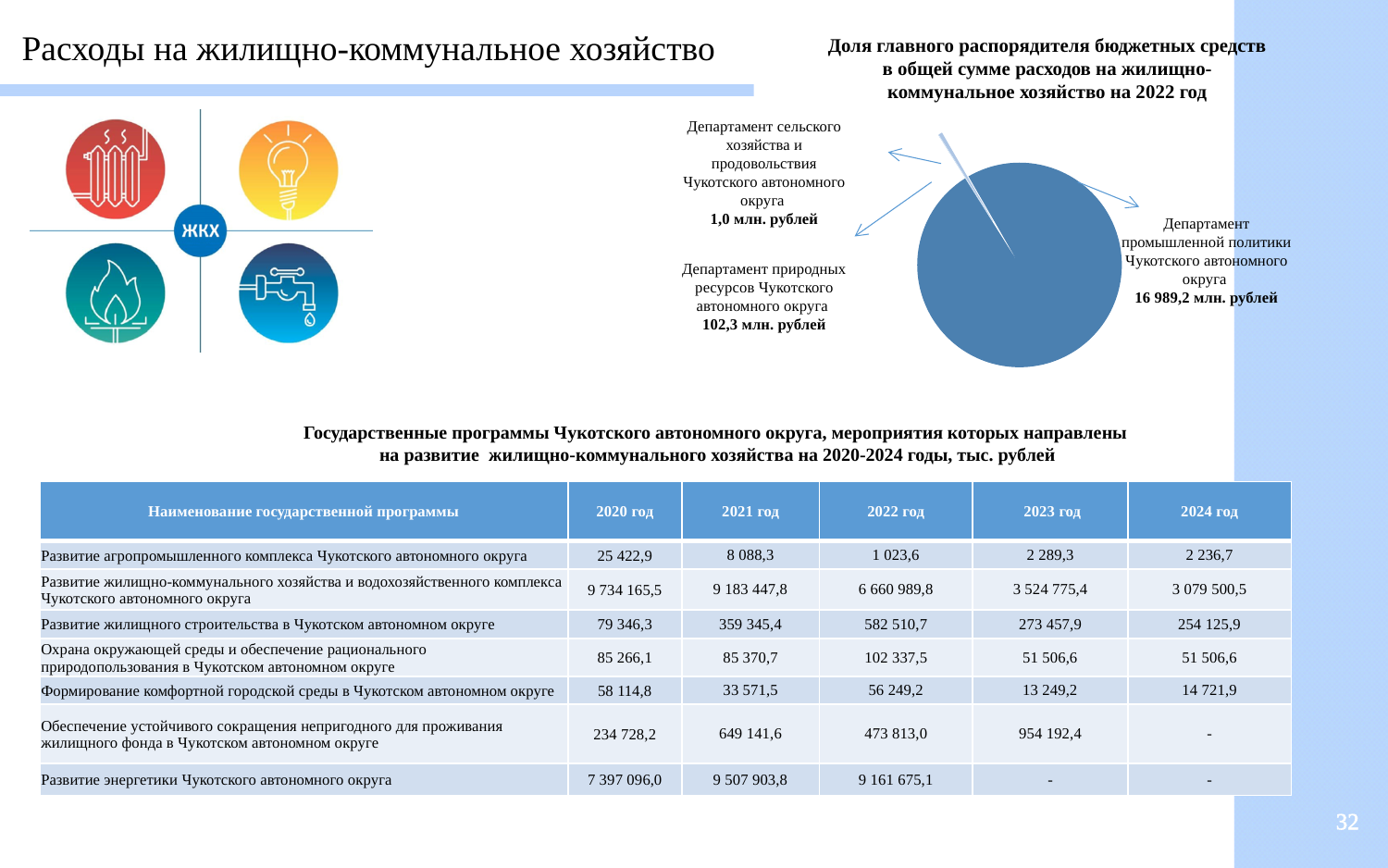
What is the difference between the values for Департамент промышленной политики and Департамент природных ресурсов in the pie chart? 16 886,9 млн. рублей Which department has the largest share in the pie chart? Департамент промышленной политики Чукотского автономного округа Which is larger in the pie chart: the value for Департамент природных ресурсов or the value for Департамент сельского хозяйства и продовольствия? Департамент природных ресурсов What is the value shown for Департамент природных ресурсов Чукотского автономного округа in the pie chart? 102,3 млн. рублей What is the value shown for Департамент сельского хозяйства и продовольствия Чукотского автономного округа in the pie chart? 1,0 млн. рублей What is the difference between the values for Департамент природных ресурсов and Департамент сельского хозяйства и продовольствия in the pie chart? 101,3 млн. рублей What is the title of the pie chart? Доля главного распорядителя бюджетных средств в общей сумме расходов на жилищно-коммунальное хозяйство на 2022 год What is the value shown for Департамент промышленной политики Чукотского автономного округа in the pie chart? 16 989,2 млн. рублей For which year does the pie chart show the shares of budget administrators? 2022 Which department has the smallest share in the pie chart? Департамент сельского хозяйства и продовольствия Чукотского автономного округа How many slices (categories) does the pie chart have? 3 What kind of chart is shown on the slide? Pie chart